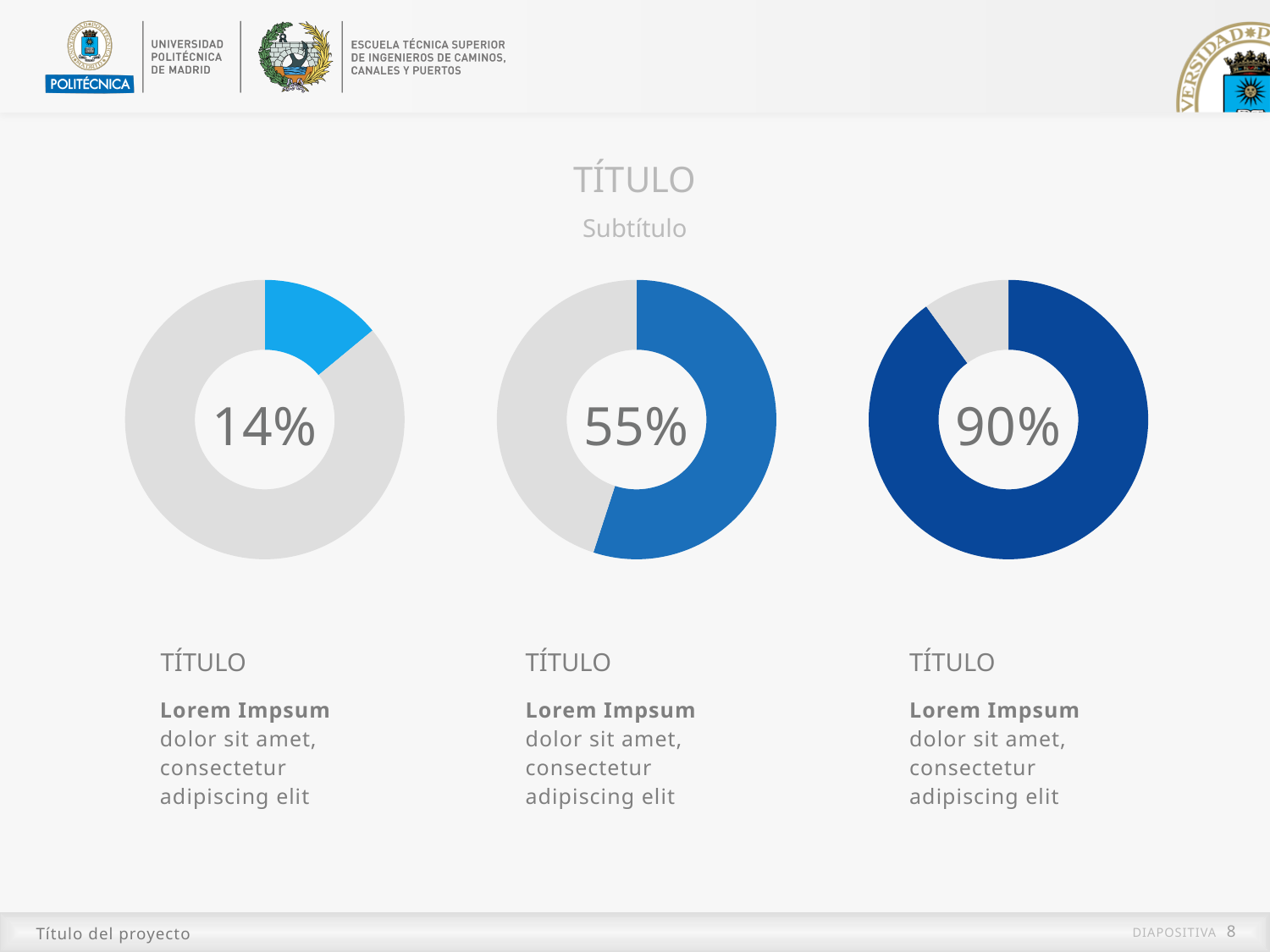
Do the percentages increase or decrease when reading the three donut charts from left to right? increase What percentage is shown in the centre of the middle donut chart? 55% Is the percentage in the middle donut chart larger or smaller than the percentage in the right donut chart? smaller What percentage is shown in the centre of the right donut chart? 90% How many donut charts are shown on the slide? 3 What is the difference between the percentage in the right donut chart and the percentage in the left donut chart? 76% In the left donut chart, what share of the ring is filled with the coloured (light blue) segment? 14% Which of the three donut charts shows the highest percentage: left, middle or right? right Which of the three donut charts shows the lowest percentage: left, middle or right? left What kind of chart is used to display the three percentages on the slide? donut chart What percentage is shown in the centre of the left donut chart? 14% What is the difference between the percentage in the middle donut chart and the percentage in the left donut chart? 41%